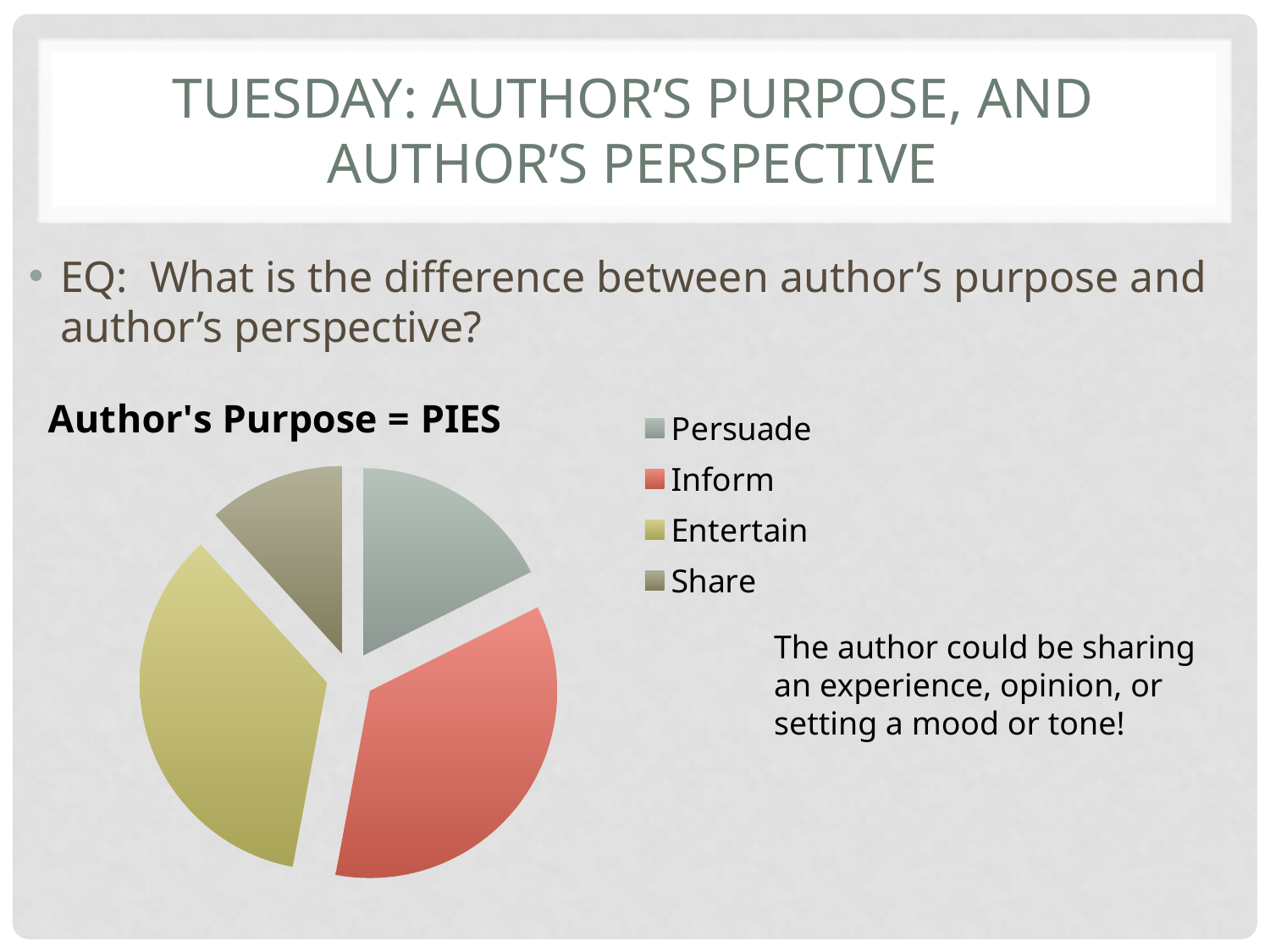
Which legend entry is listed first in the chart's legend? Persuade Which slice of the pie chart is the smallest? Share What kind of chart is shown on the slide? Pie chart What is the title of the chart? Author's Purpose = PIES Which category is shown in red in the pie chart? Inform How many entries does the chart's legend list? 4 Which slice is larger, Inform or Persuade? Inform Which slice is larger, Persuade or Share? Persuade Which slice is larger, Entertain or Share? Entertain How many slices does the pie chart have? 4